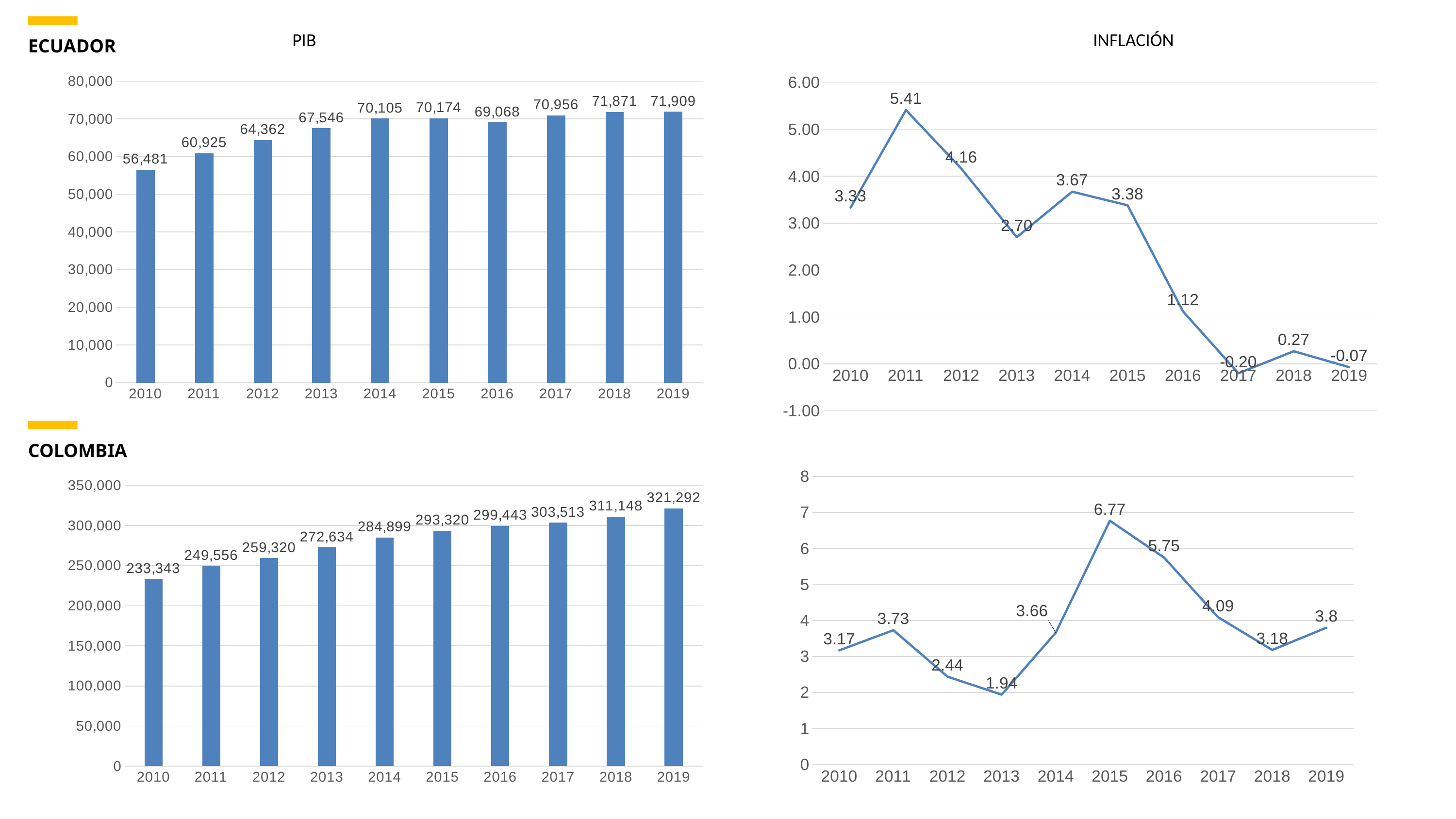
What kind of chart is the Ecuador PIB chart (top left)? bar chart In the Ecuador PIB bar chart (top left), what is the value for 2013? 67,546 In the Colombia PIB bar chart (bottom left), how many years are shown? 10 In the Ecuador PIB bar chart (top left), which year has the lowest value? 2010 In the Ecuador INFLACIÓN line chart (top right), what is the difference between the 2014 and 2015 values? 0.29 In the Colombia PIB bar chart (bottom left), what is the value for 2016? 299,443 In the Colombia inflation line chart (bottom right), which year has the highest value? 2015 In the Colombia inflation line chart (bottom right), which is larger, the value for 2012 or the value for 2018? 2018 In the Ecuador INFLACIÓN line chart (top right), which year has the lowest value? 2017 In the Colombia PIB bar chart (bottom left), do the values rise or fall from 2010 to 2019? rise In the Ecuador INFLACIÓN line chart (top right), what is the value for 2011? 5.41 In the Ecuador PIB bar chart (top left), which year has the highest value? 2019